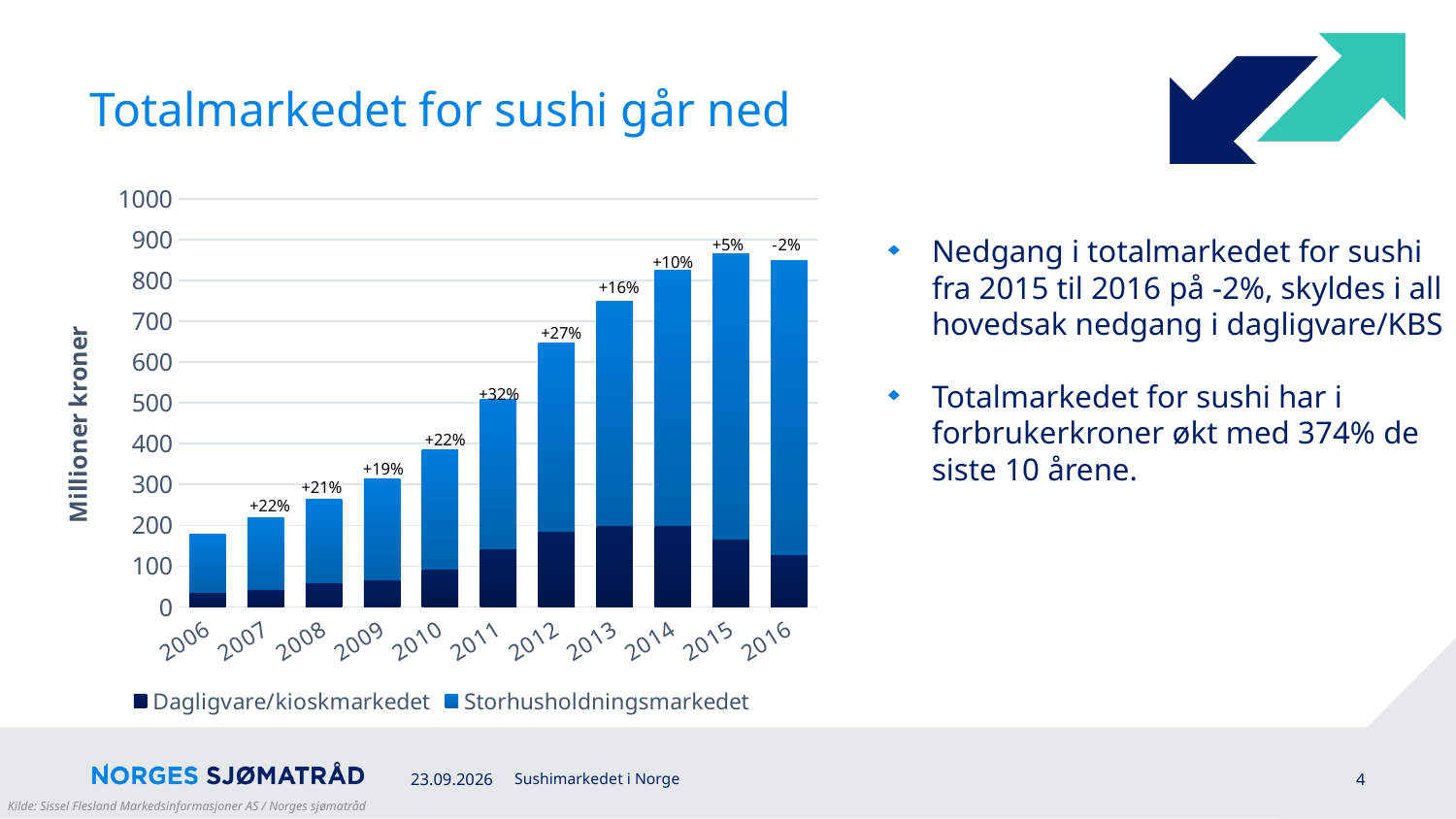
How many series does the chart's legend list? 2 Is the total value for 2013 greater or less than 700? greater How many years are shown along the x axis of the chart? 11 Which year has the highest total bar in the chart? 2015 Which year has the lowest total bar in the chart? 2006 What percentage change is labelled above the bar for 2016? -2% What percentage change is labelled above the bar for 2011? +32% What percentage change is labelled above the bar for 2014? +10% Which year has the larger total bar, 2010 or 2012? 2012 What is the label on the chart's y axis? Millioner kroner Is the total value for 2008 greater or less than 300? less What kind of chart is shown on the slide? bar chart